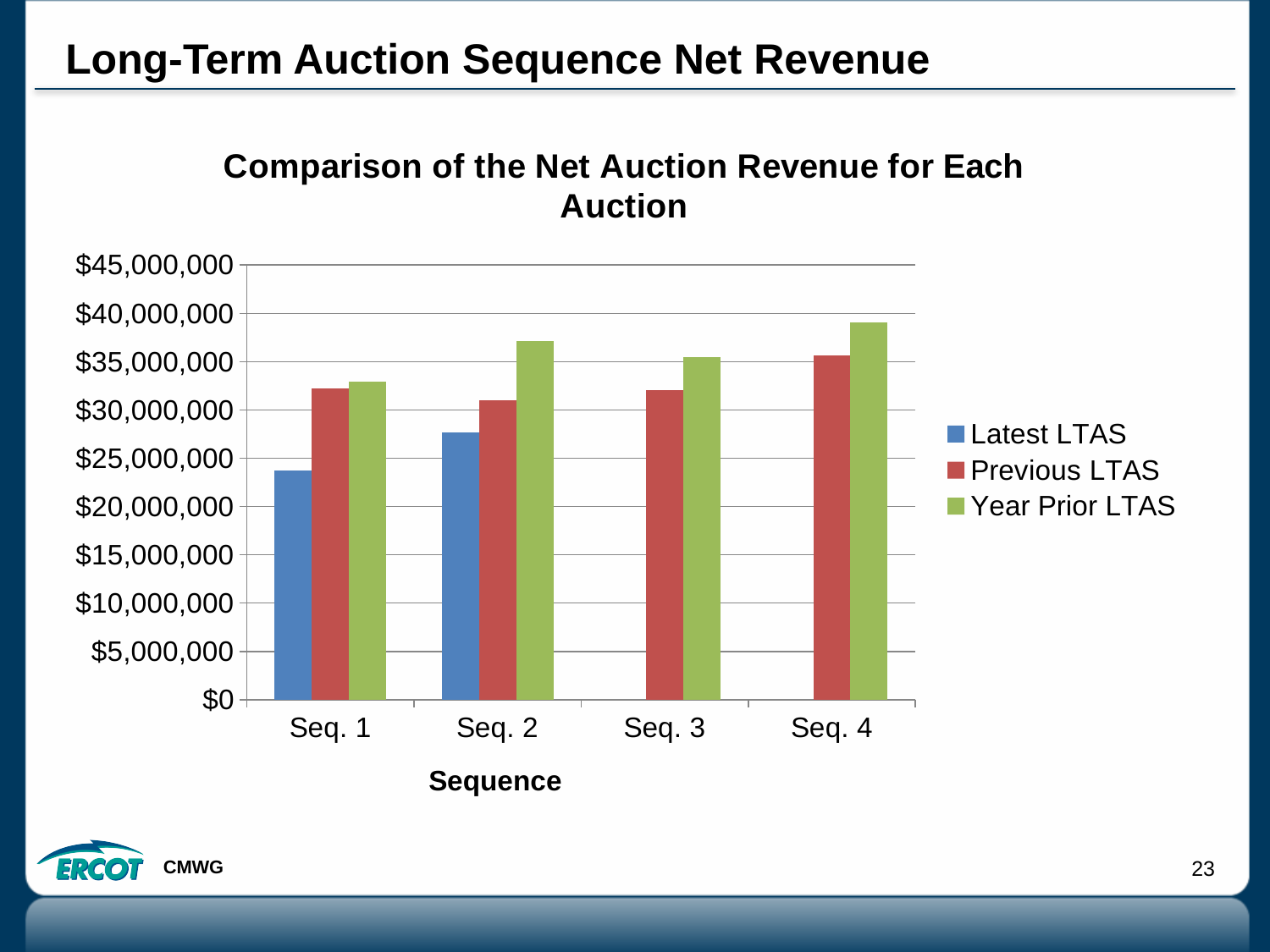
What kind of chart is shown on the slide? bar chart For Seq. 2, which is larger: Latest LTAS or Previous LTAS? Previous LTAS Does the Previous LTAS value rise or fall from Seq. 3 to Seq. 4? rises In which sequence is the Year Prior LTAS value highest? Seq. 4 How many series does the legend list? 3 Is the Year Prior LTAS value for Seq. 2 greater or less than $35,000,000? greater How many sequence categories are shown on the x axis? 4 Is the Latest LTAS value for Seq. 1 greater or less than $25,000,000? less In which sequence is the Latest LTAS value lowest? Seq. 1 Is the Year Prior LTAS value for Seq. 4 greater or less than $35,000,000? greater What is the title of the chart? Comparison of the Net Auction Revenue for Each Auction For how many sequences is a Latest LTAS bar plotted? 2